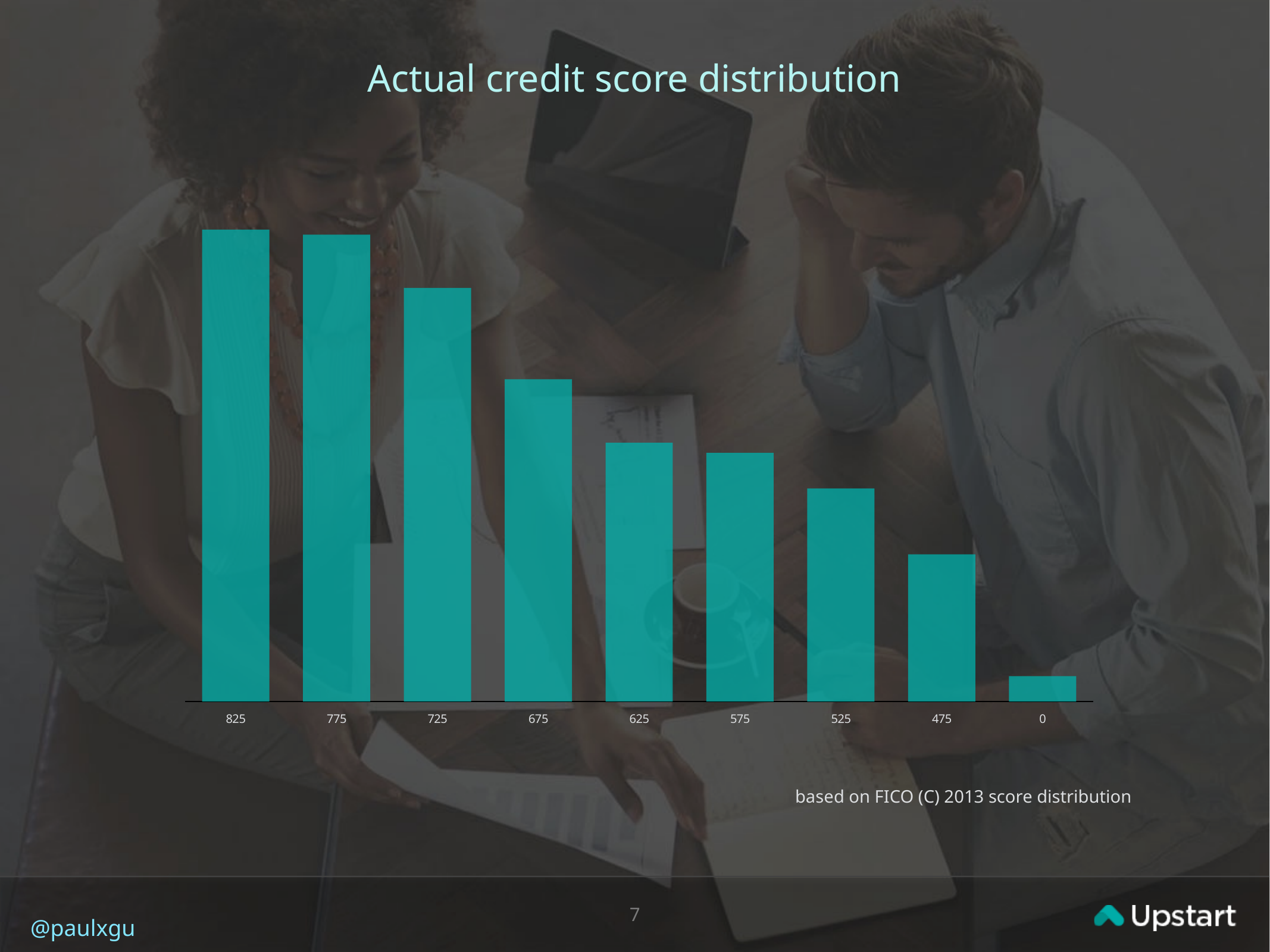
What kind of chart is shown on the slide? bar chart Which is larger, the value for 825 or the value for 525? 825 How many bars (categories) does the chart show? 9 What is the label of the leftmost category on the x axis? 825 Which is larger, the value for 475 or the value for 0? 475 What is the title of the chart? Actual credit score distribution Which is larger, the value for 725 or the value for 675? 725 Which category has the lowest bar? 0 Do the bar values rise or fall moving from left to right along the x axis? fall